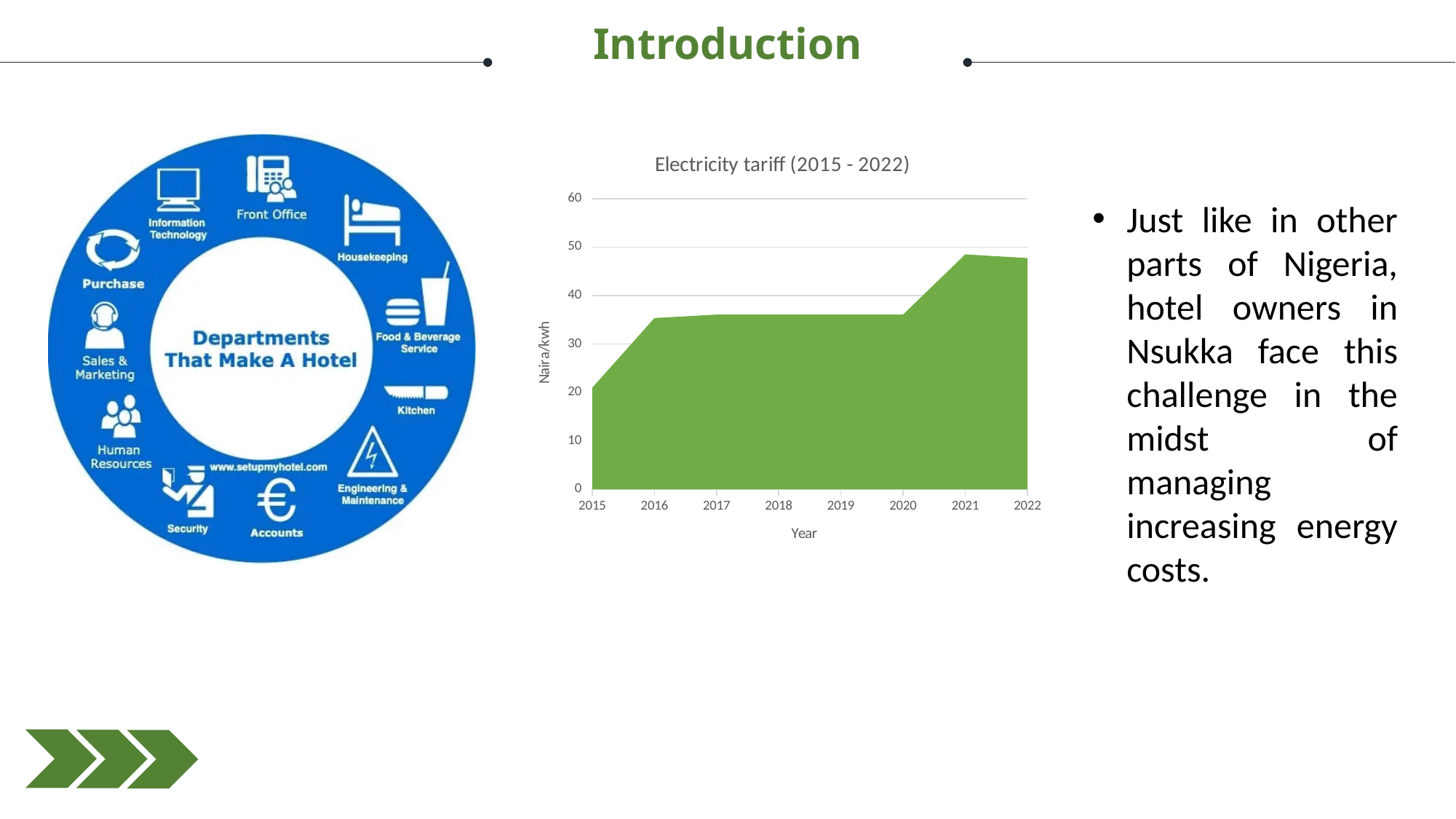
In the Electricity tariff chart, which year has the lowest value? 2015 In the Electricity tariff chart, is the value for 2022 greater or less than 50? less What is the title of the chart on the slide? Electricity tariff (2015 - 2022) In the Electricity tariff chart, which is larger, the value for 2021 or the value for 2018? 2021 In the Electricity tariff chart, is the value for 2016 greater or less than 30? greater How many years are shown on the x axis of the Electricity tariff chart? 8 In the Electricity tariff chart, is the value for 2021 greater or less than 40? greater What is the label on the vertical axis of the Electricity tariff chart? Naira/kwh Does the electricity tariff generally rise or fall from 2015 to 2022? Rise What kind of chart is the Electricity tariff (2015 - 2022) chart? Area chart